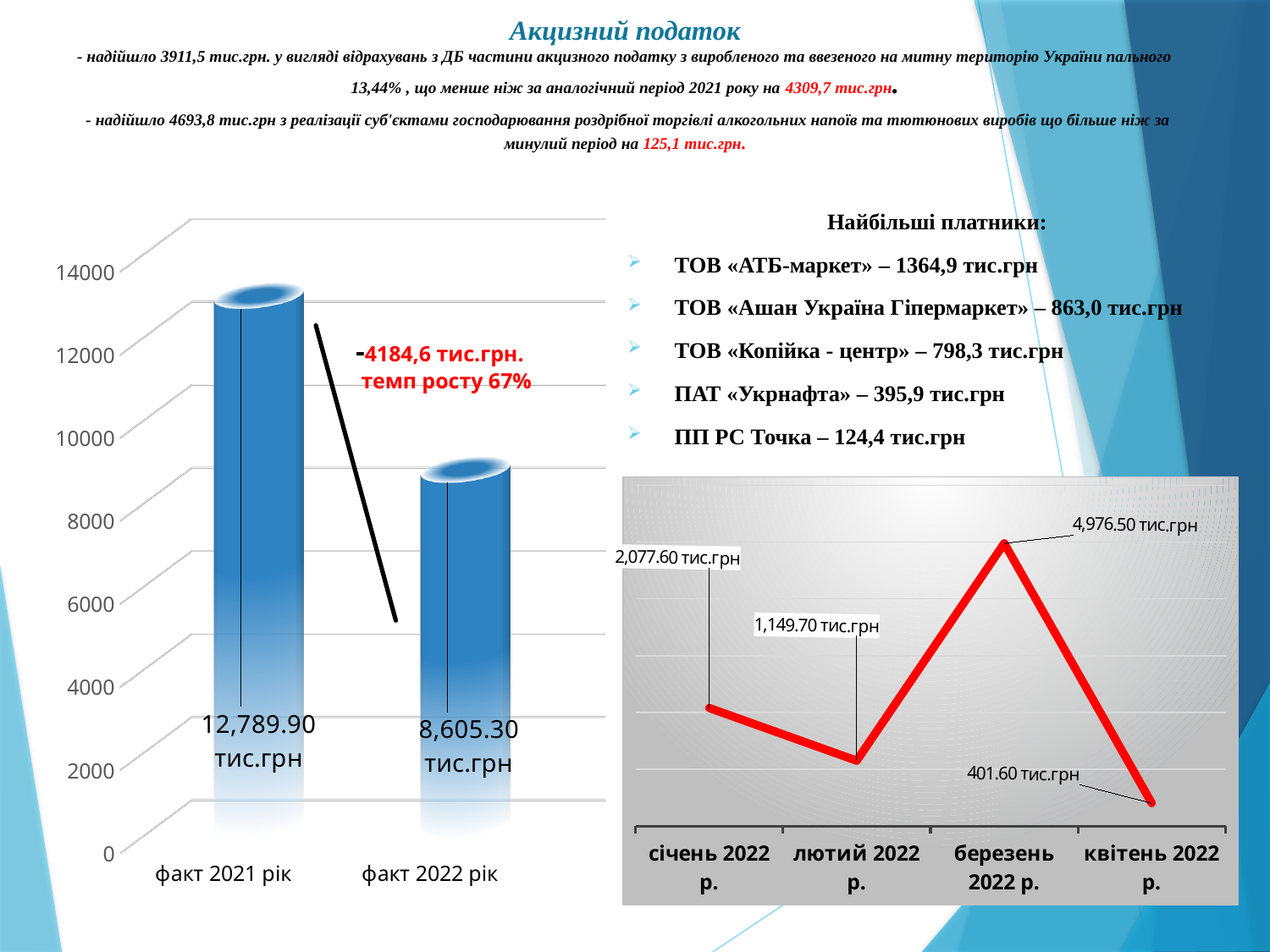
In the line chart on the right, what is the difference between the values for березень 2022 р. and лютий 2022 р.? 3,826.80 тис.грн In the line chart on the right, which month has the highest value? березень 2022 р. In the bar chart on the left, what is the value for факт 2022 рік? 8,605.30 тис.грн In the bar chart on the left, what is the value for факт 2021 рік? 12,789.90 тис.грн In the bar chart on the left, what is the difference between the values for факт 2021 рік and факт 2022 рік? 4,184.60 тис.грн In the bar chart on the left, how many bars are plotted? 2 In the bar chart on the left, which category has the higher value? факт 2021 рік In the line chart on the right, how many data points are plotted? 4 In the line chart on the right, what is the value for березень 2022 р.? 4,976.50 тис.грн What kind of chart is shown on the left of the slide? Bar chart In the line chart on the right, which month has the lowest value? квітень 2022 р. In the line chart on the right, what is the value for квітень 2022 р.? 401.60 тис.грн